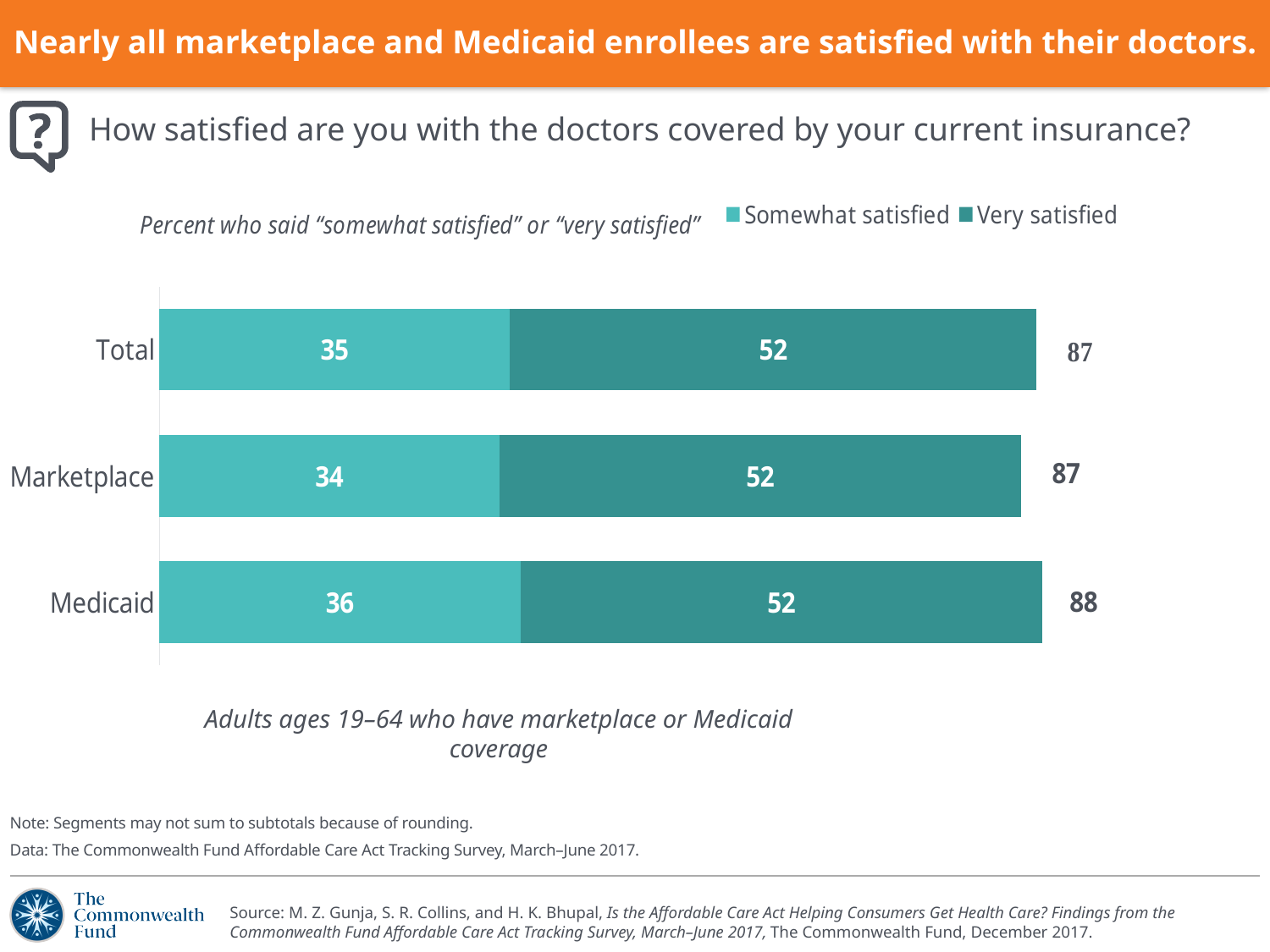
What is the difference between the "very satisfied" and "somewhat satisfied" values for the Total category? 17 What percent of Marketplace enrollees said they were "very satisfied" with the doctors covered by their insurance? 52 What is the combined percent satisfied (somewhat or very) shown at the end of the Medicaid bar? 88 How many categories are shown on the chart? 3 What percent of Medicaid enrollees said they were "somewhat satisfied" with the doctors covered by their insurance? 36 Is the "somewhat satisfied" value larger for Medicaid or for Marketplace? Medicaid What kind of chart is shown on the slide? Stacked bar chart Which category has the highest "somewhat satisfied" value? Medicaid How many series does the legend list? 2 Which category has the lowest "somewhat satisfied" value? Marketplace What is the "somewhat satisfied" value for the Total category? 35 What is the combined percent satisfied shown at the end of the Marketplace bar? 87